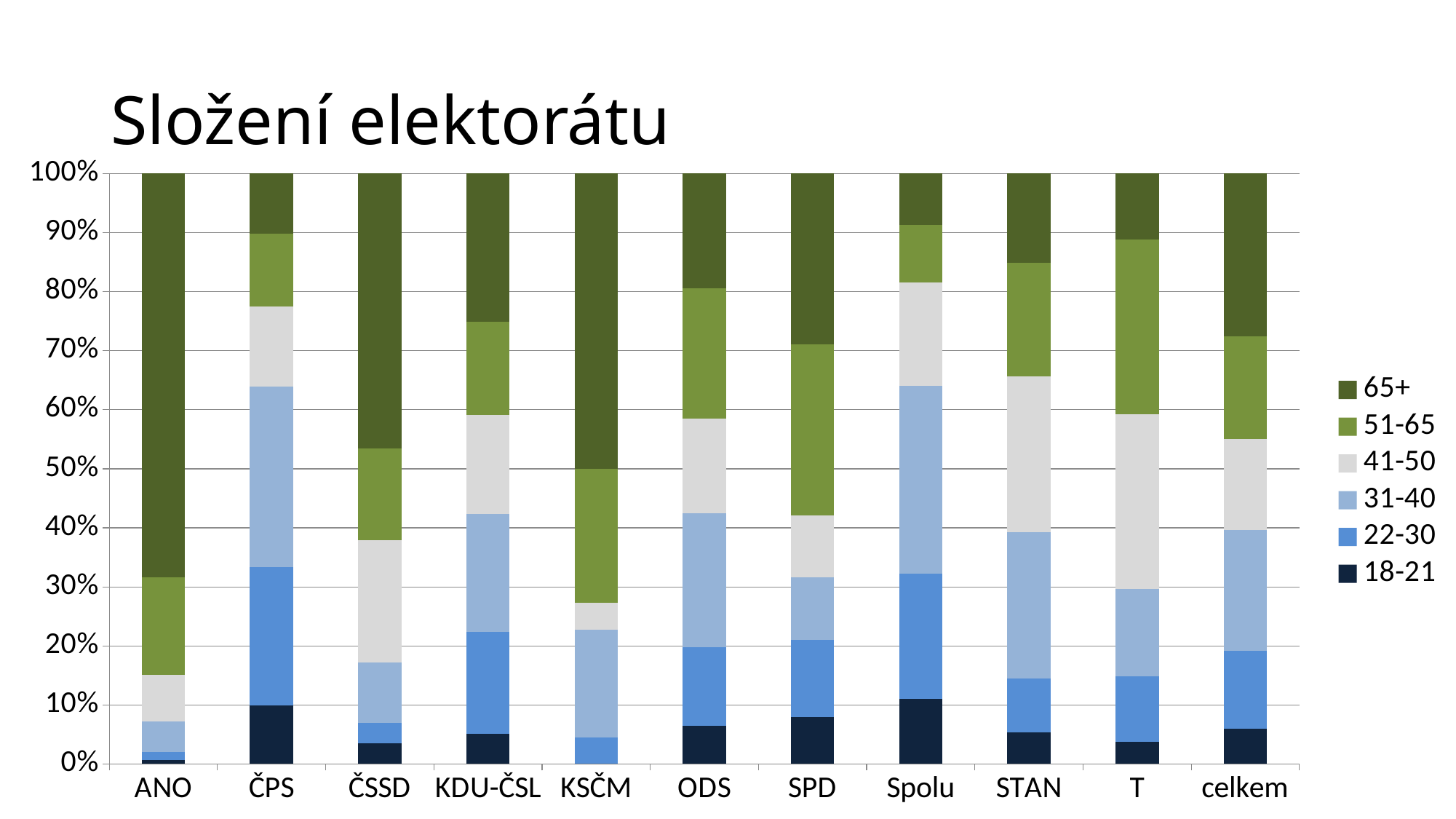
Which has the larger 65+ share, ANO or ČPS? ANO Which legend entry is shown in the darkest green colour? 65+ Is the 18-21 share for ČSSD greater or less than 10%? less What is the title of the chart? Složení elektorátu Which has the larger 18-21 share, ANO or ČPS? ČPS How many series does the legend list? 6 Which category has the largest 65+ share? ANO Which has the larger 31-40 share, ANO or ČPS? ČPS How many categories are shown on the x axis? 11 Is the 18-21 share for ANO greater or less than 10%? less Is the combined share of 18-21 and 22-30 for ČPS greater or less than 20%? greater What kind of chart is shown on the slide? stacked bar chart